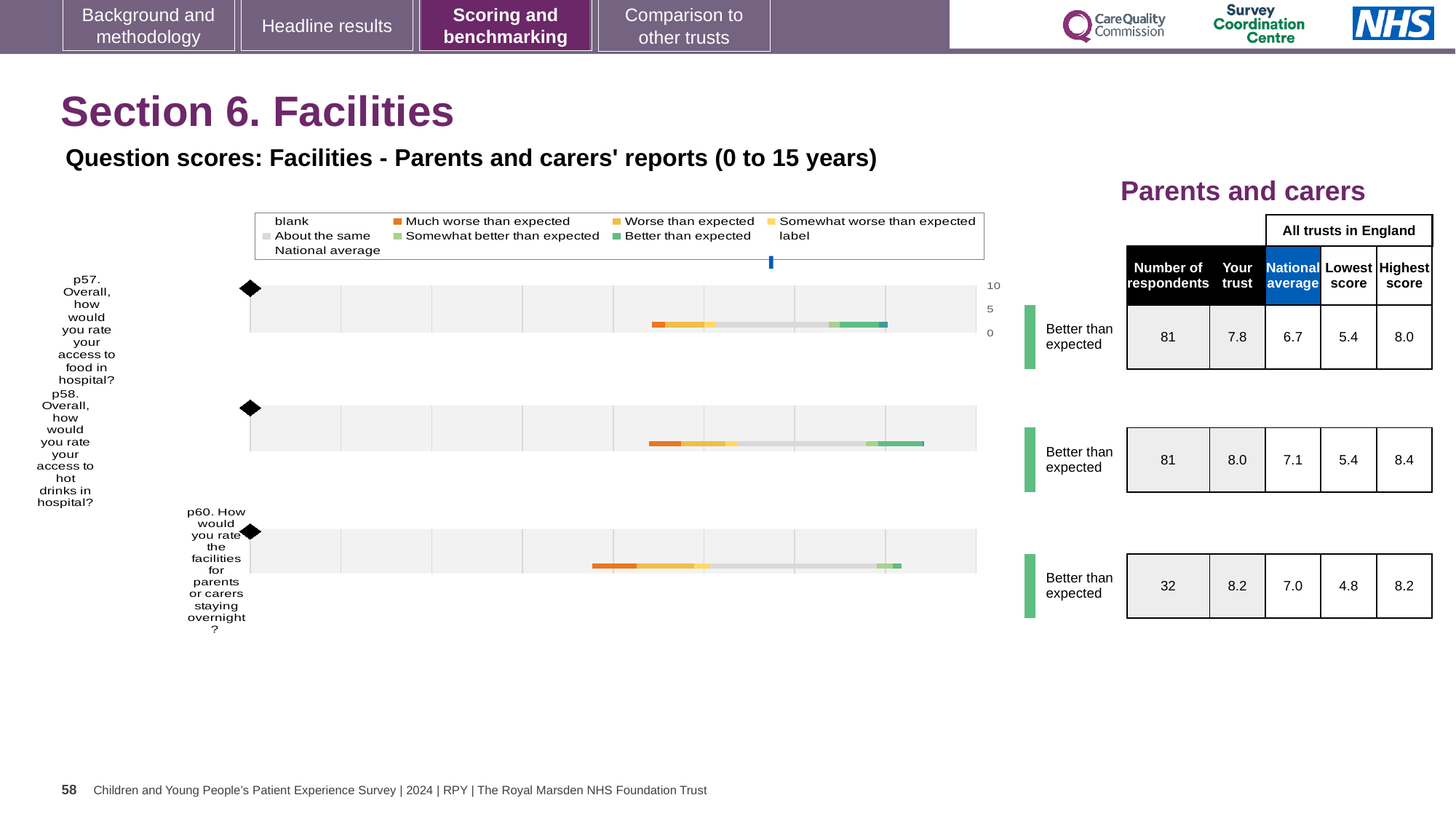
For p57, which is larger: the 'Your trust' score or the national average? Your trust Which question has the highest 'Your trust' score? p60 By how much does the 'Your trust' score for p57 exceed the national average? 1.1 How many questions (categories) are plotted in the chart? 3 What kind of chart is used to show the question scores on this slide? Bar chart How many respondents answered p60 (facilities for parents or carers staying overnight)? 32 What is the 'Your trust' score for p57 (access to food in hospital)? 7.8 What is the difference between the highest score and the lowest score for p58? 3.0 What is the lowest score across all trusts in England for p60? 4.8 What is the title of the chart on this slide? Question scores: Facilities - Parents and carers' reports (0 to 15 years) What benchmark category is shown for p57? Better than expected What is the national average score for p58 (access to hot drinks in hospital)? 7.1